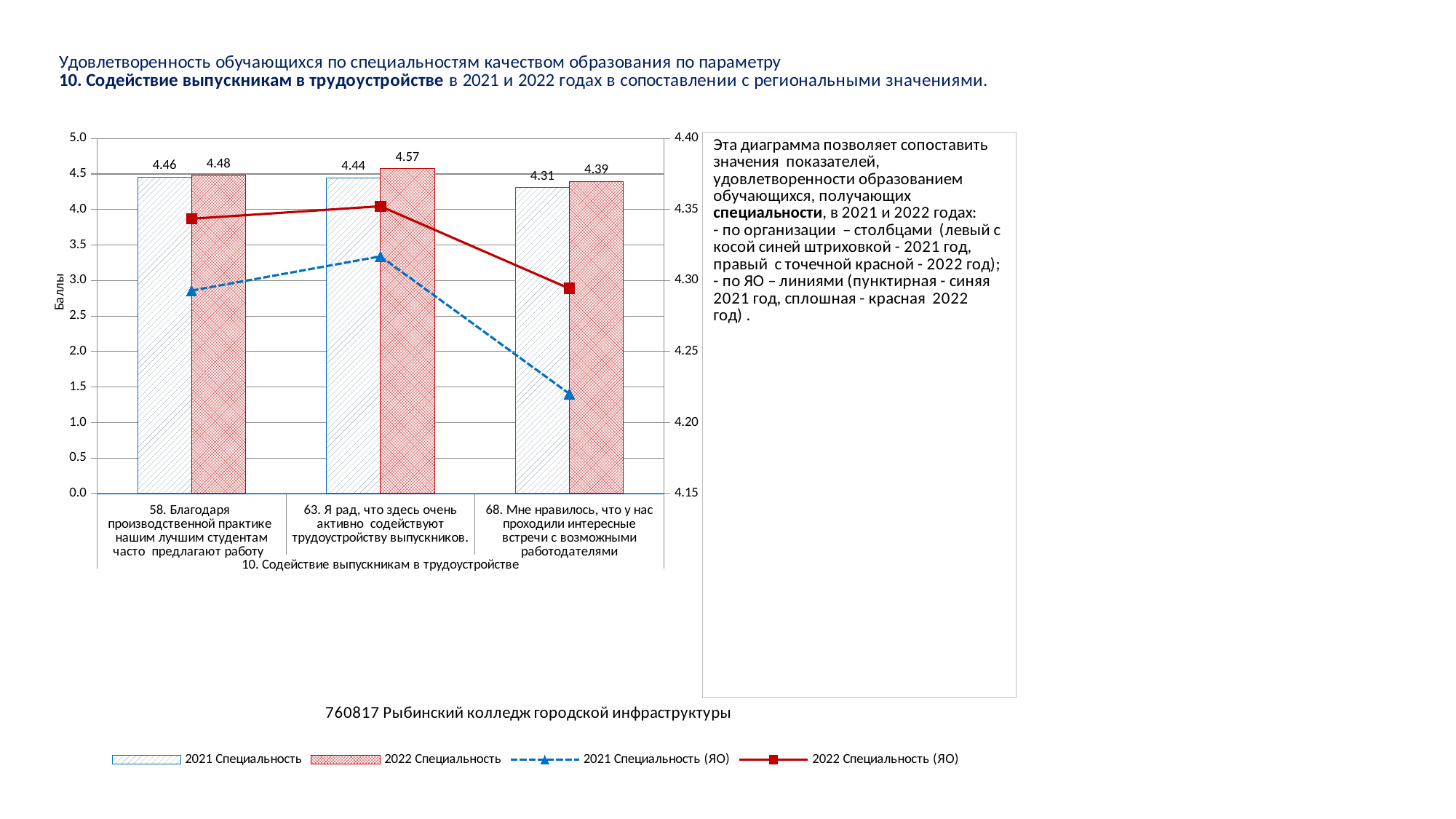
What is the value of the 2022 Специальность bar for item 68 (Мне нравилось, что у нас проходили интересные встречи с возможными работодателями)? 4.39 Do the 2021 Специальность bar values rise or fall from item 58 to item 68? fall How many items (categories) are shown on the x axis? 3 What is the value of the 2022 Специальность bar for item 63 (Я рад, что здесь очень активно содействуют трудоустройству выпускников)? 4.57 What is the difference between the 2022 and 2021 Специальность bars for item 63? 0.13 Which item has the highest 2022 Специальность bar? 63. Я рад, что здесь очень активно содействуют трудоустройству выпускников. How many series does the legend list? 4 For item 68, which bar is larger: 2021 Специальность or 2022 Специальность? 2022 Специальность Is the 2021 Специальность (ЯО) line value for item 68 greater or less than 4.25 on the right axis? less Is the 2021 Специальность (ЯО) line value for item 63 greater or less than 4.30 on the right axis? greater Which item has the lowest 2021 Специальность bar? 68. Мне нравилось, что у нас проходили интересные встречи с возможными работодателями What is the value of the 2021 Специальность bar for item 58 (Благодаря производственной практике...)? 4.46